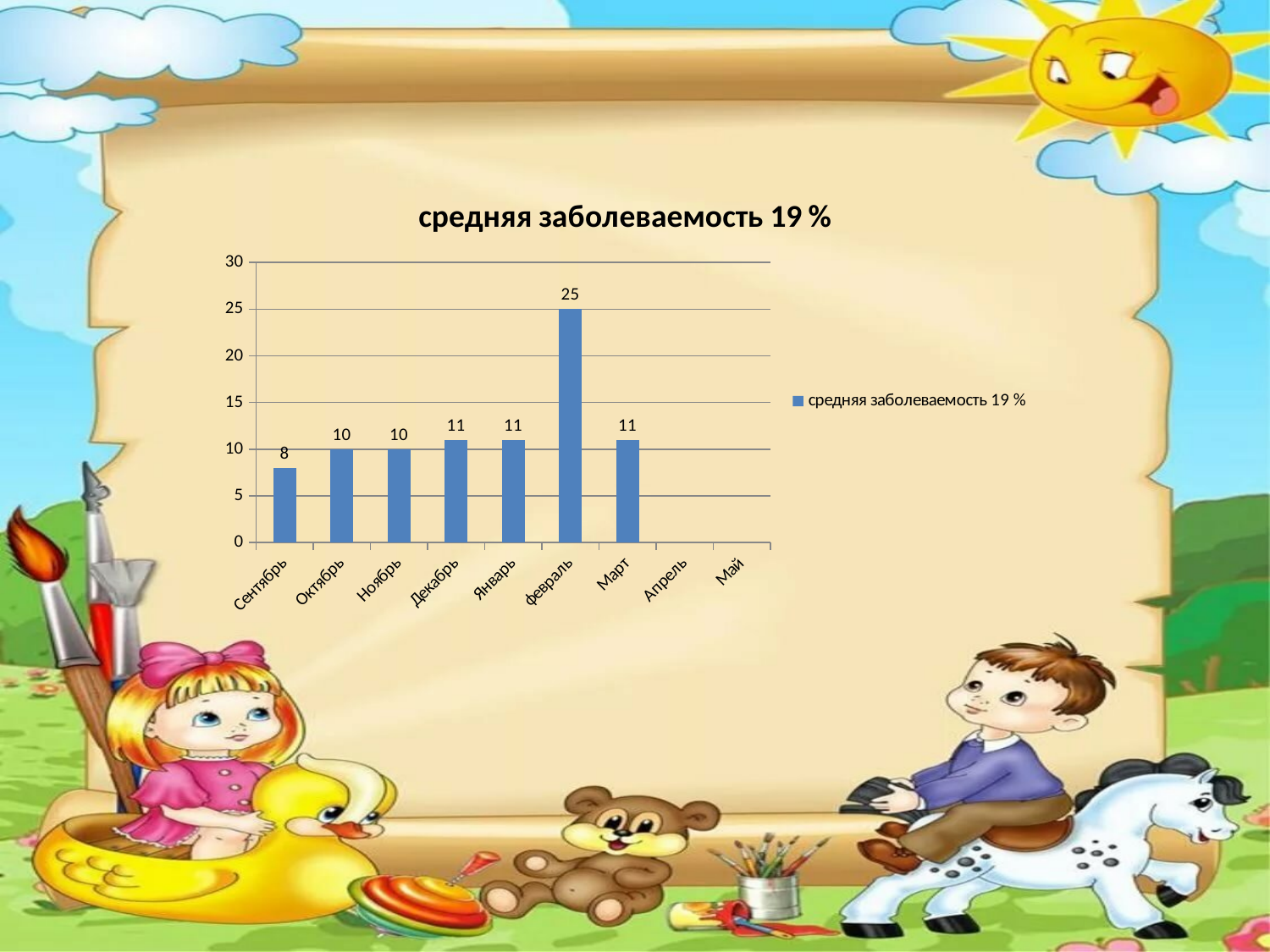
What is the title of the chart? средняя заболеваемость 19 % What is the value for Сентябрь? 8 How many series does the legend list? 1 Among the months with a plotted bar, which has the lowest value? Сентябрь Which is larger, the value for Октябрь or the value for Январь? Январь How many month categories are shown on the x axis? 9 What is the difference between the values for Февраль and Март? 14 What is the value for Февраль? 25 What is the value for Декабрь? 11 What kind of chart is shown? bar chart Is the value for Февраль greater or less than 20? greater Which month has the highest value? Февраль